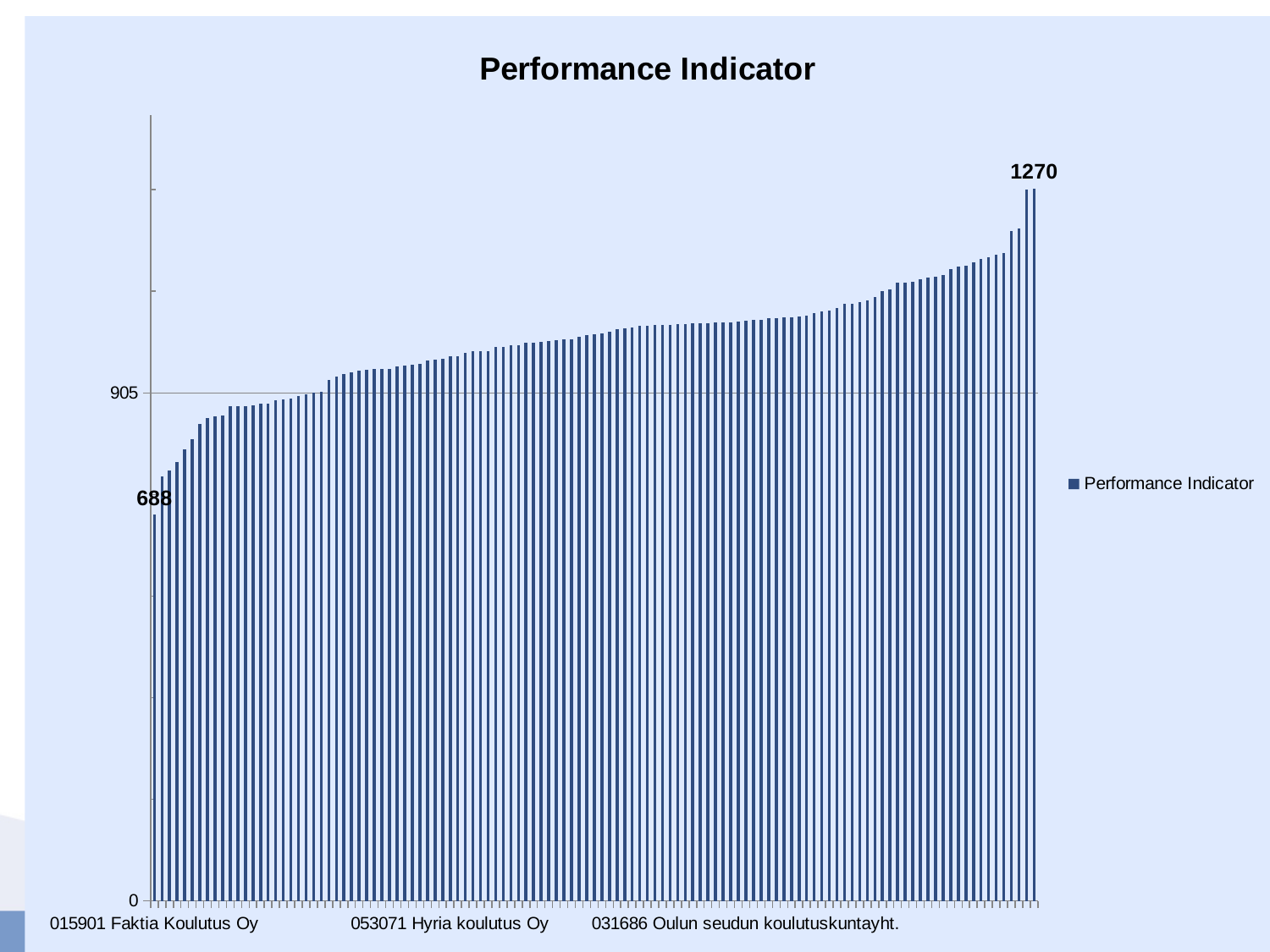
What is the value for 015901 Faktia Koulutus Oy? 688 Which is larger, the value of the leftmost bar or the value of the rightmost bar? the rightmost bar What is the difference between the highest labelled value (1270) and the lowest labelled value (688)? 582 Is the value for 031686 Oulun seudun koulutuskuntayht. greater or less than 905? greater How many series does the legend list? 1 Is the value for 015901 Faktia Koulutus Oy greater or less than 905? less Do the bar values rise or fall from left to right along the x axis? rise What is the lowest value shown in the chart? 688 Is the value for 053071 Hyria koulutus Oy greater or less than 905? greater What kind of chart is shown on the slide? bar chart What is the title of the chart? Performance Indicator What is the highest value shown in the chart? 1270